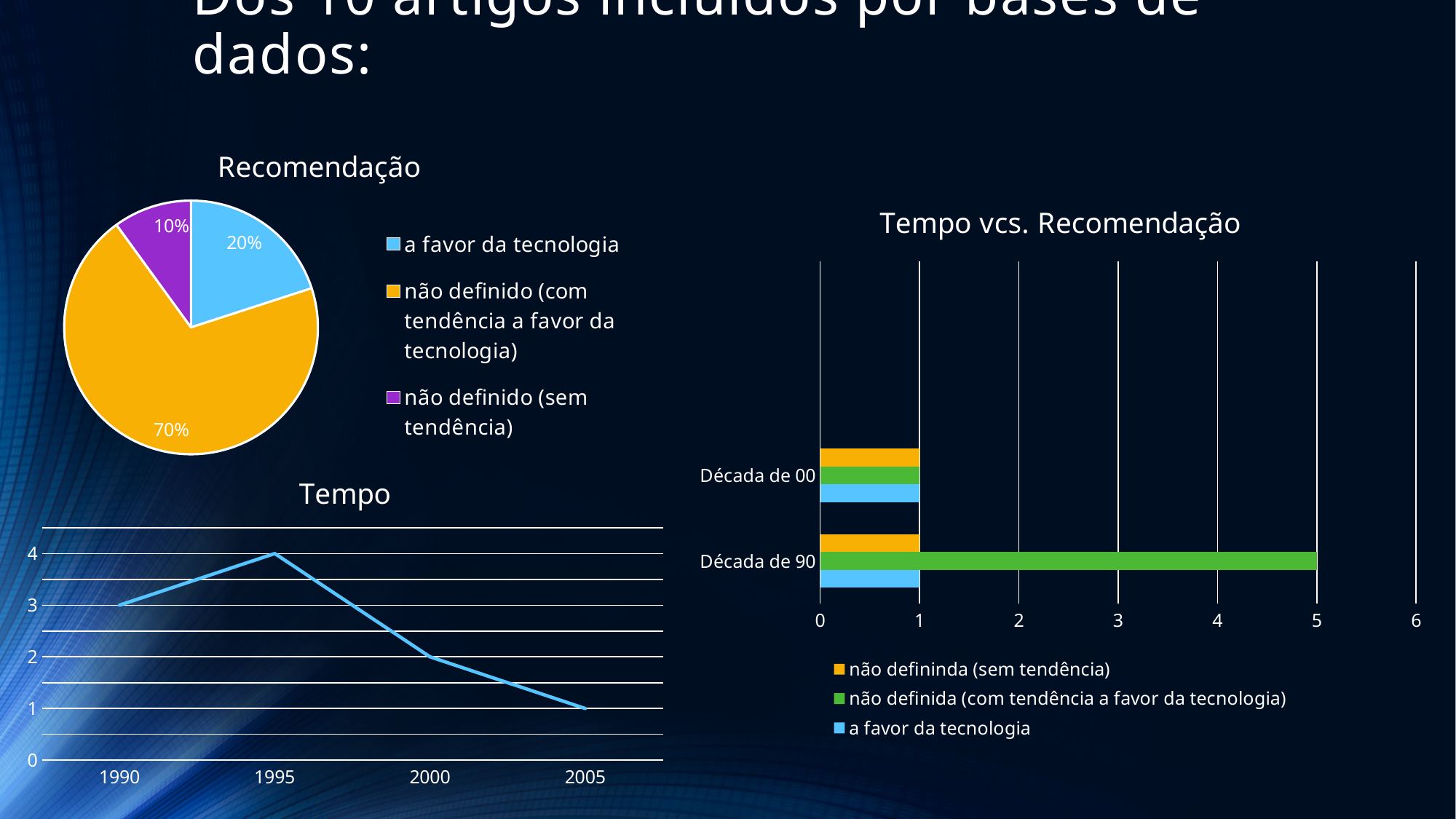
In the "Tempo" line chart, do the values rise or fall from 1995 to 2005? fall In the "Tempo vcs. Recomendação" chart, which is larger: the green bar for Década de 90 or the green bar for Década de 00? Década de 90 In the "Recomendação" pie chart, what share is labelled for "a favor da tecnologia"? 20% In the "Recomendação" pie chart, how many slices are there? 3 In the "Recomendação" pie chart, which category has the largest slice? não definido (com tendência a favor da tecnologia) In the "Recomendação" pie chart, which category has the smallest slice? não definido (sem tendência) In the "Tempo" line chart, which year has the lowest value? 2005 In the "Tempo vcs. Recomendação" chart, what is the value for "não definida (com tendência a favor da tecnologia)" in Década de 90? 5 In the "Tempo" line chart, what is the difference between the values for 1995 and 2005? 3 In the "Tempo vcs. Recomendação" chart, how many series does the legend list? 3 In the "Tempo" line chart, what is the value for 1995? 4 What kind of chart is the "Recomendação" chart? pie chart